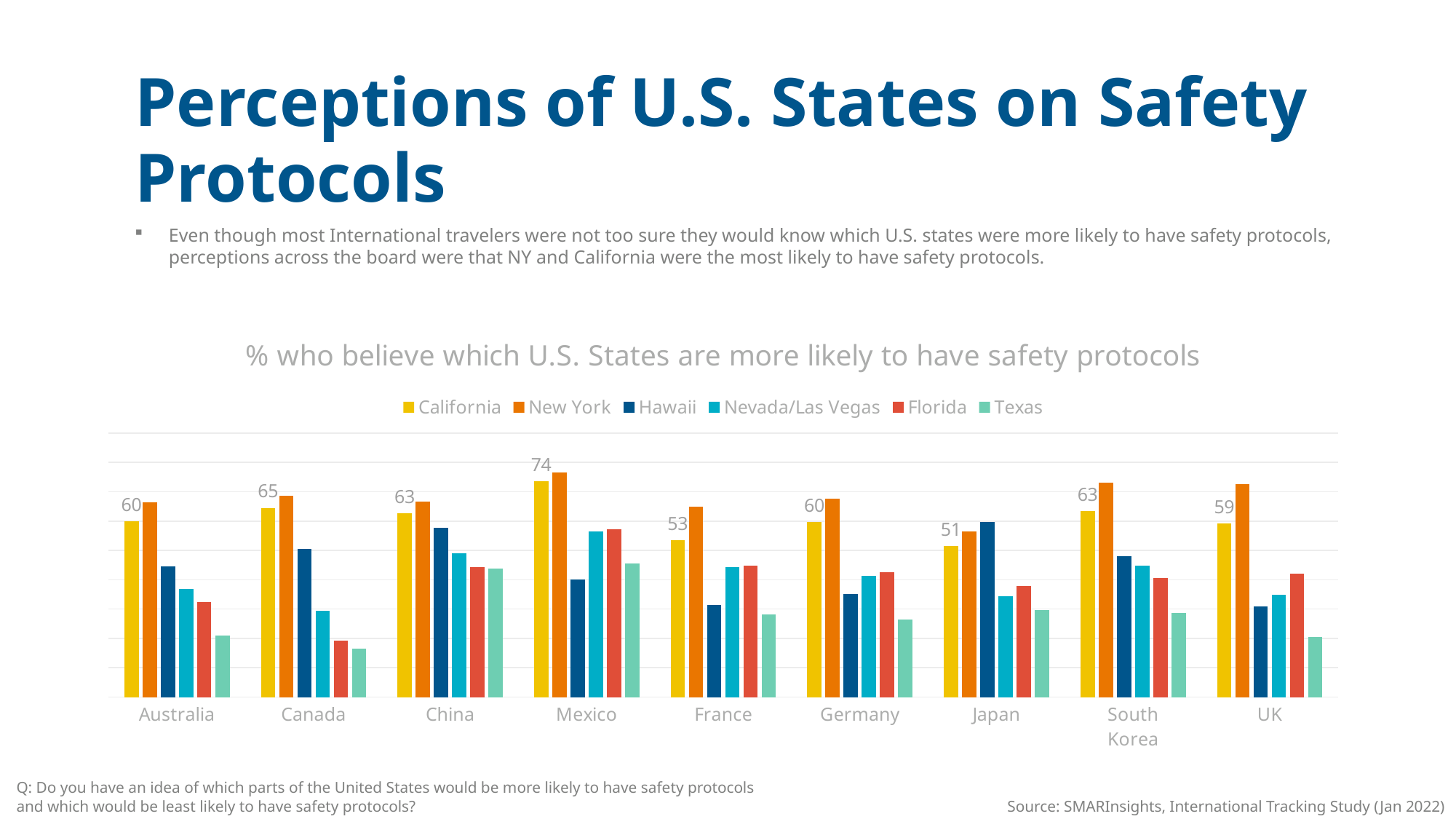
Which country has the highest value for California? Mexico Which country has the lowest value for California? Japan What is the value for California among Mexico respondents? 74 Among Japan respondents, which is higher, Hawaii or New York? Hawaii What is the difference between the California values for Canada and Australia? 5 How many series does the legend list? 6 What is the value for California among France respondents? 53 Which has the higher California value, Canada or China? Canada How many countries are shown on the x axis? 9 What kind of chart is shown on the slide? Bar chart What is the difference between the California values for Mexico and Japan? 23 What is the value for California among Japan respondents? 51